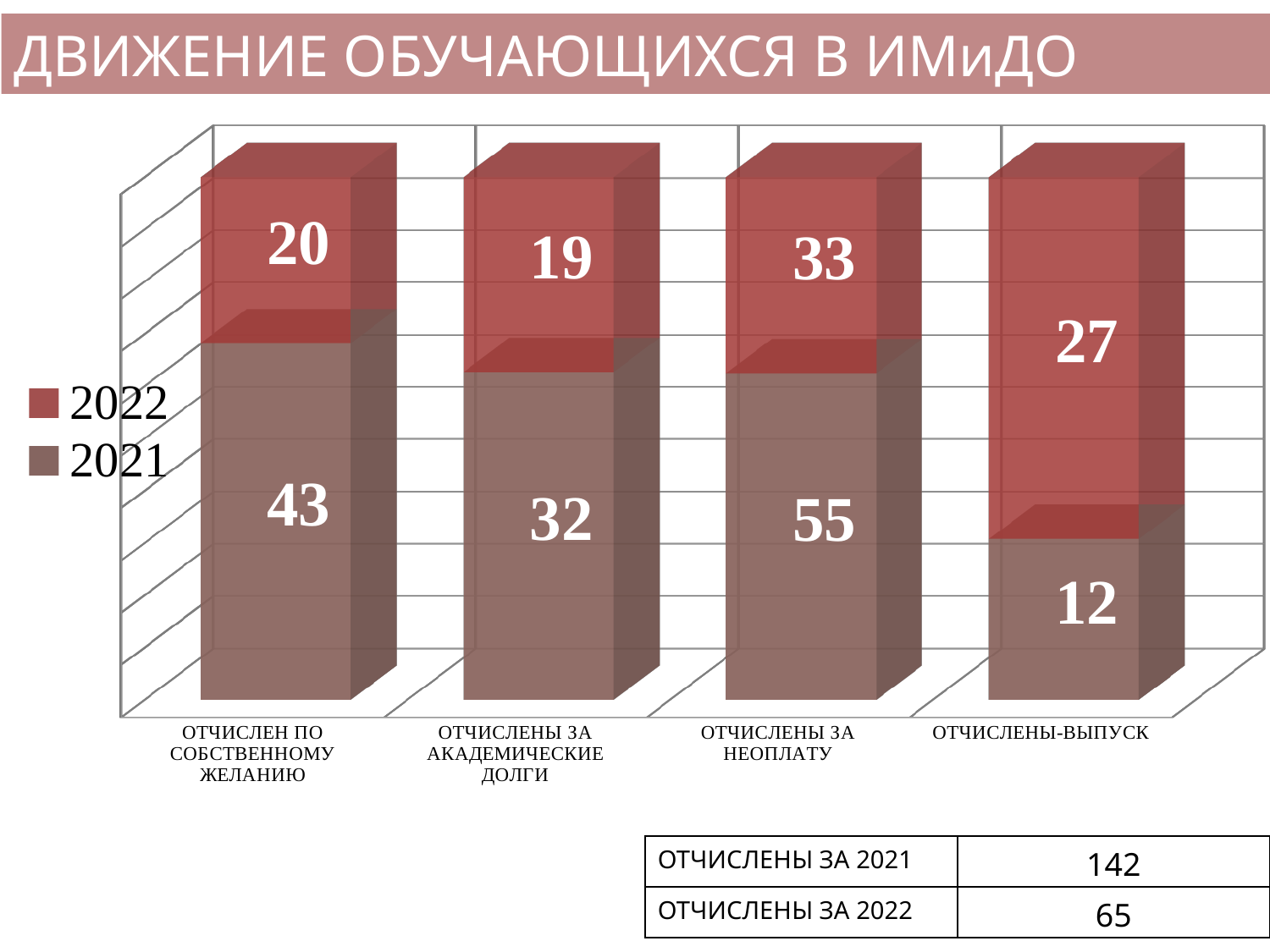
What is the combined total of the 2021 and 2022 values for ОТЧИСЛЕН ПО СОБСТВЕННОМУ ЖЕЛАНИЮ? 63 What is the 2022 value for ОТЧИСЛЕНЫ-ВЫПУСК? 27 What is the difference between the 2021 and 2022 values for ОТЧИСЛЕНЫ ЗА НЕОПЛАТУ? 22 How many series does the legend list? 2 Which category has the highest 2021 value? ОТЧИСЛЕНЫ ЗА НЕОПЛАТУ How many categories are shown on the x axis? 4 What is the 2021 value for ОТЧИСЛЕНЫ ЗА НЕОПЛАТУ? 55 Which category has the lowest 2021 value? ОТЧИСЛЕНЫ-ВЫПУСК What is the 2021 value for ОТЧИСЛЕН ПО СОБСТВЕННОМУ ЖЕЛАНИЮ? 43 Which category has the lowest 2022 value? ОТЧИСЛЕНЫ ЗА АКАДЕМИЧЕСКИЕ ДОЛГИ What is the 2022 value for ОТЧИСЛЕНЫ ЗА АКАДЕМИЧЕСКИЕ ДОЛГИ? 19 Which is larger for ОТЧИСЛЕНЫ-ВЫПУСК: the 2021 value or the 2022 value? 2022